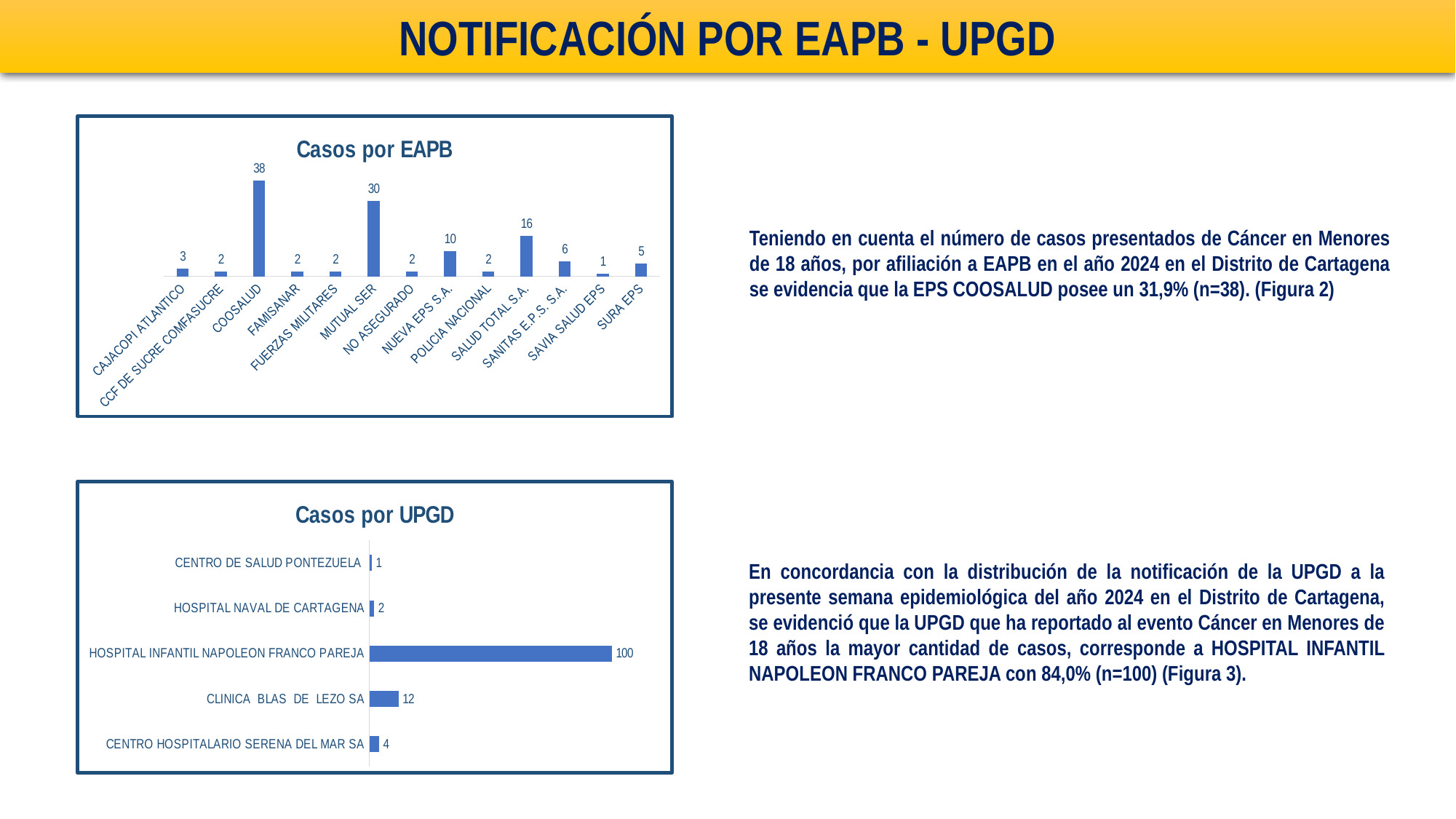
In the 'Casos por EAPB' chart, which EAPB has the highest number of cases? COOSALUD In the 'Casos por UPGD' chart, which UPGD has the lowest number of cases? CENTRO DE SALUD PONTEZUELA What type of chart is the 'Casos por UPGD' chart? Bar chart In the 'Casos por UPGD' chart, what is the value for HOSPITAL INFANTIL NAPOLEON FRANCO PAREJA? 100 How many categories are shown in the 'Casos por EAPB' chart? 13 In the 'Casos por UPGD' chart, what is the value for CLINICA BLAS DE LEZO SA? 12 In the 'Casos por EAPB' chart, which is larger, SALUD TOTAL S.A. or NUEVA EPS S.A.? SALUD TOTAL S.A. In the 'Casos por EAPB' chart, what is the value for COOSALUD? 38 In the 'Casos por EAPB' chart, which EAPB has the lowest number of cases? SAVIA SALUD EPS How many categories are shown in the 'Casos por UPGD' chart? 5 In the 'Casos por EAPB' chart, what is the value for MUTUAL SER? 30 In the 'Casos por EAPB' chart, what is the difference between the values for COOSALUD and MUTUAL SER? 8